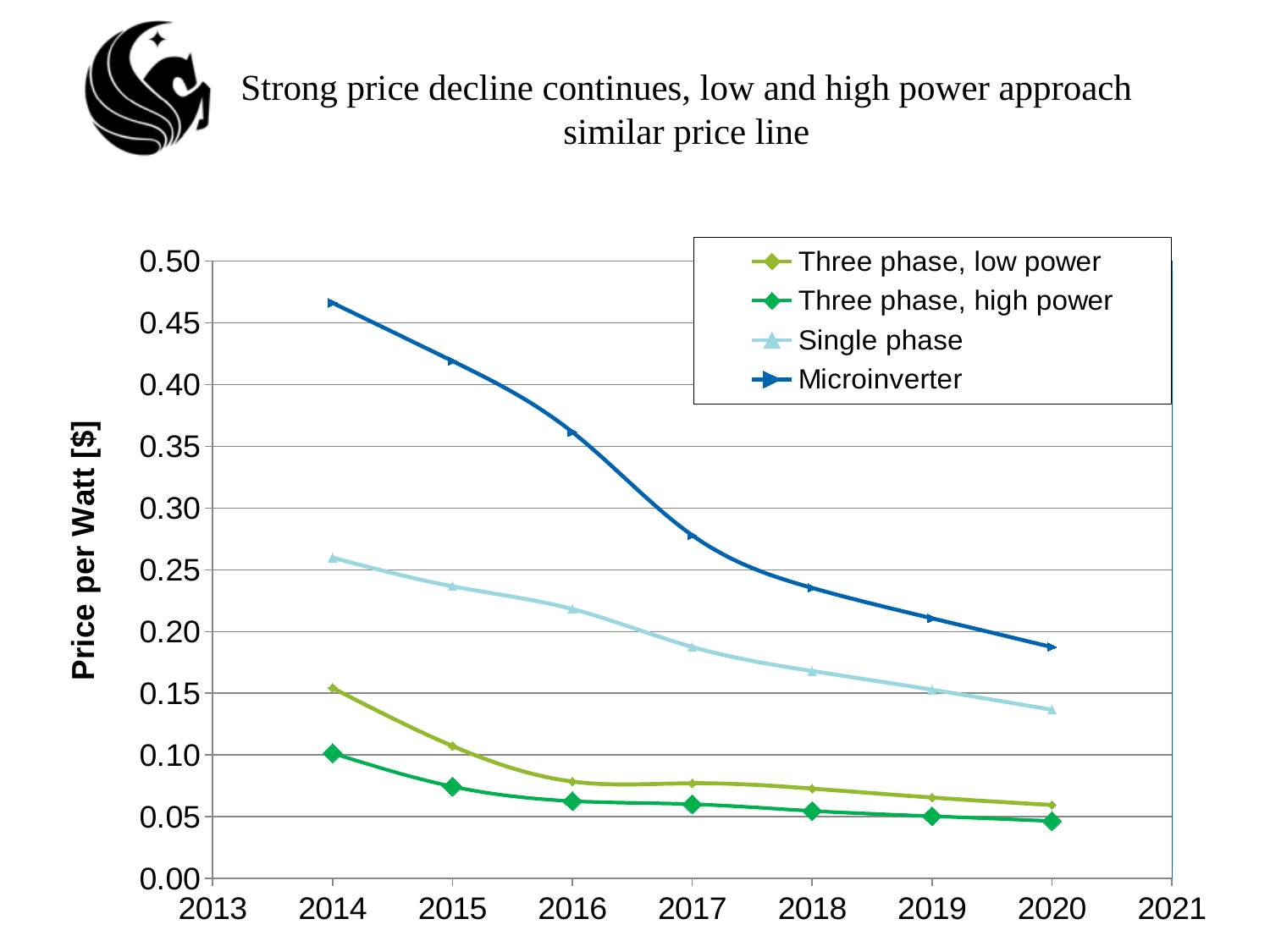
Which series has the lowest price per watt in 2020? Three phase, high power Is the Single phase value in 2014 greater or less than 0.25? greater How many data points does each series have (years plotted)? 7 How many series does the legend list? 4 What kind of chart is shown on the slide? Line chart Is the Microinverter value in 2014 greater or less than 0.45? greater Which series has the highest price per watt in 2014? Microinverter Do the Microinverter values rise or fall from 2014 to 2020? fall Is the Microinverter value in 2020 greater or less than 0.20? less In 2020, which is larger: the Single phase value or the Microinverter value? Microinverter What is the label of the vertical axis? Price per Watt [$]